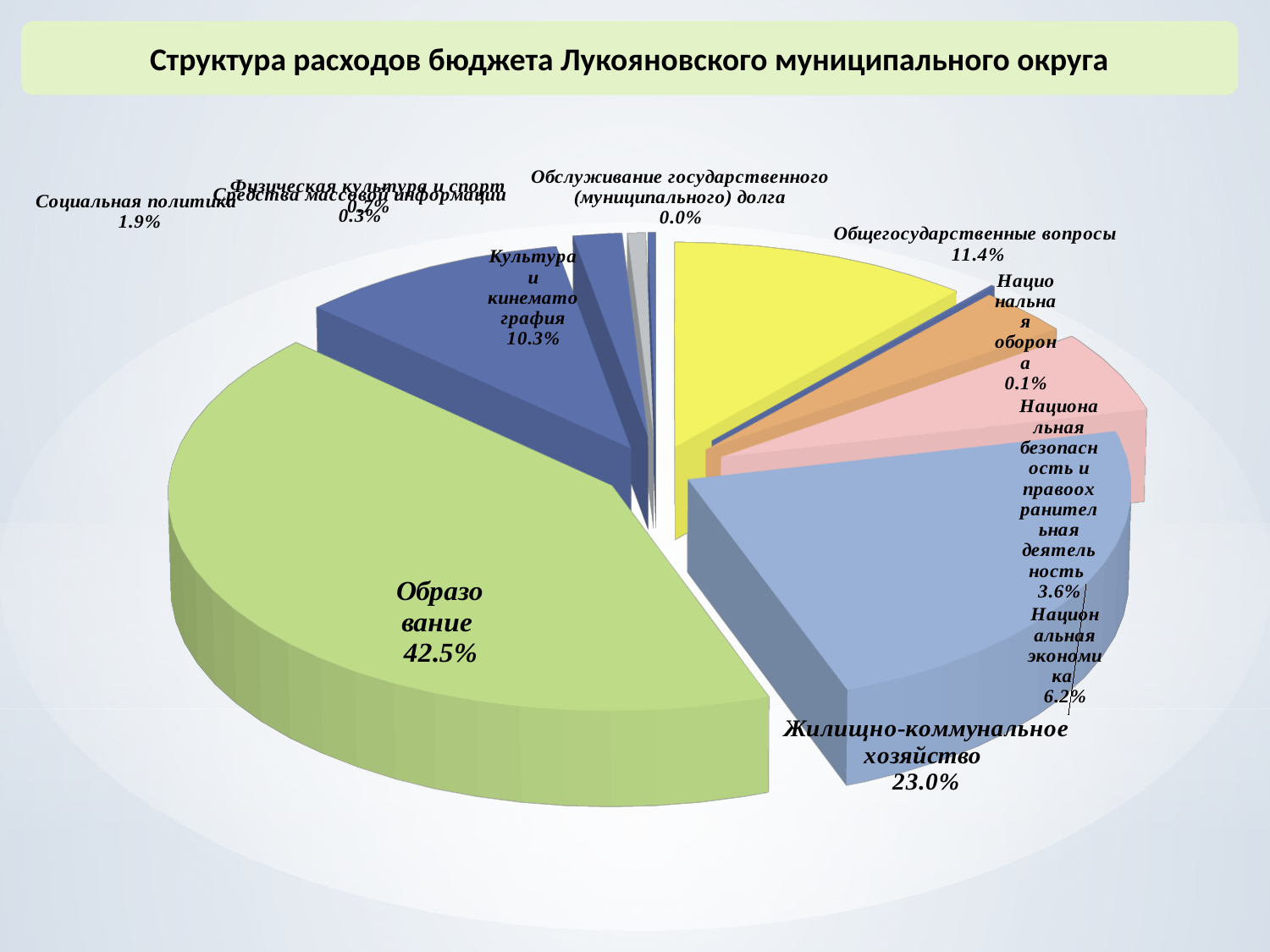
What kind of chart is shown on the slide? pie chart What is the title of the chart? Структура расходов бюджета Лукояновского муниципального округа What share is shown for Социальная политика? 1.9% Which category has the smallest share of expenditure? Обслуживание государственного (муниципального) долга By how many percentage points does the share of Образование exceed the share of Жилищно-коммунальное хозяйство? 19.5 What share is shown for Жилищно-коммунальное хозяйство? 23.0% Which has a larger share: Национальная безопасность и правоохранительная деятельность or Национальная экономика? Национальная экономика What share is shown for Общегосударственные вопросы? 11.4% What share is shown for Культура и кинематография? 10.3% What share of the budget expenditure goes to Образование? 42.5% Which category has the largest share of expenditure? Образование What share is shown for Национальная экономика? 6.2%